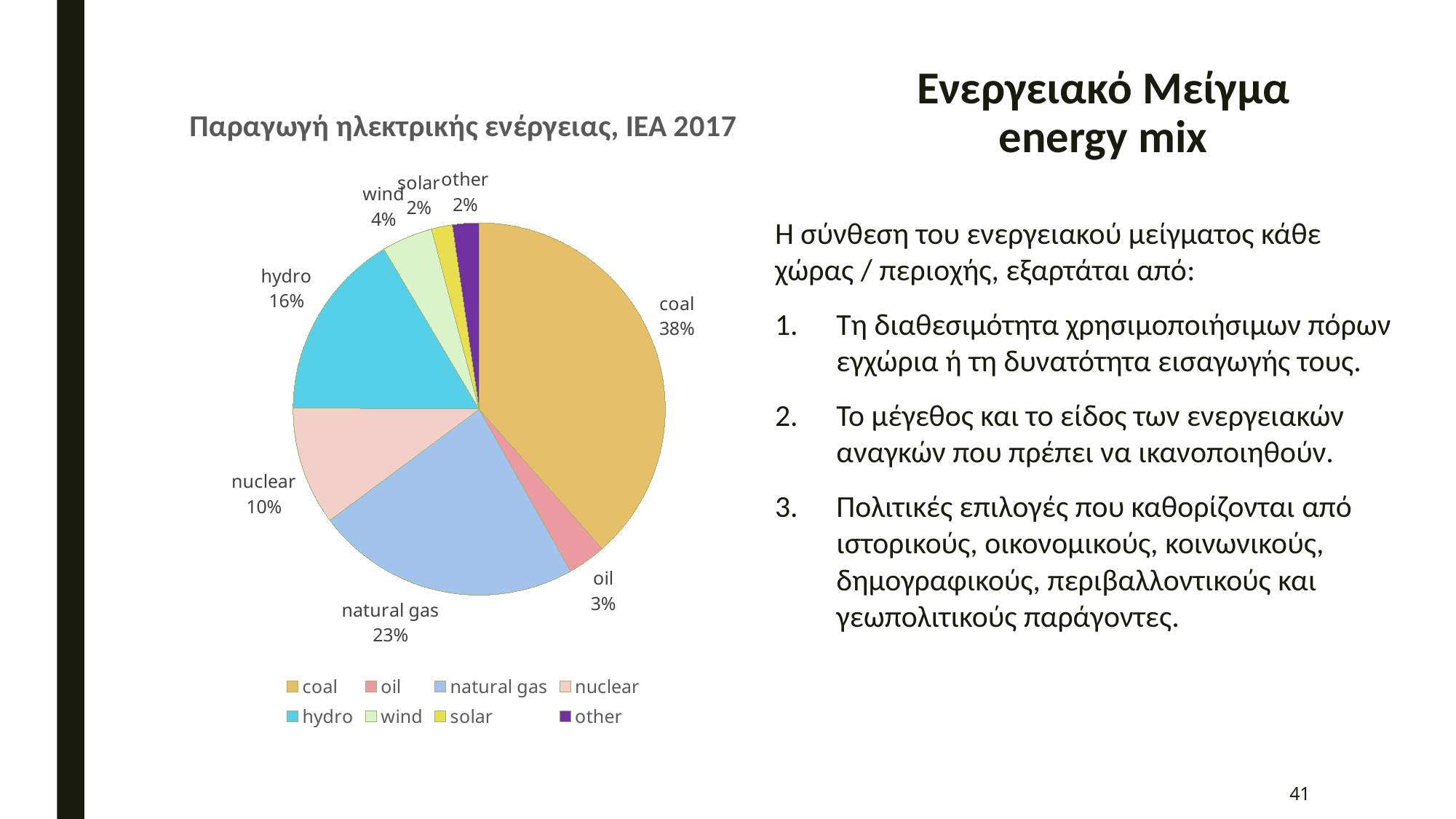
How many categories does the pie chart show? 8 What is the share of oil in the pie chart? 3% Which category has the largest slice of the pie chart? coal What colour is the slice for hydro in the pie chart? cyan What is the share of hydro in the pie chart? 16% What is the difference between the shares of coal and natural gas? 15% What is the share of coal in the pie chart? 38% What is the share of natural gas in the pie chart? 23% What type of chart is shown on the slide? pie chart Which is larger, the share of hydro or the share of nuclear? hydro What is the share of nuclear in the pie chart? 10% What is the title of the pie chart? Παραγωγή ηλεκτρικής ενέργειας, IEA 2017